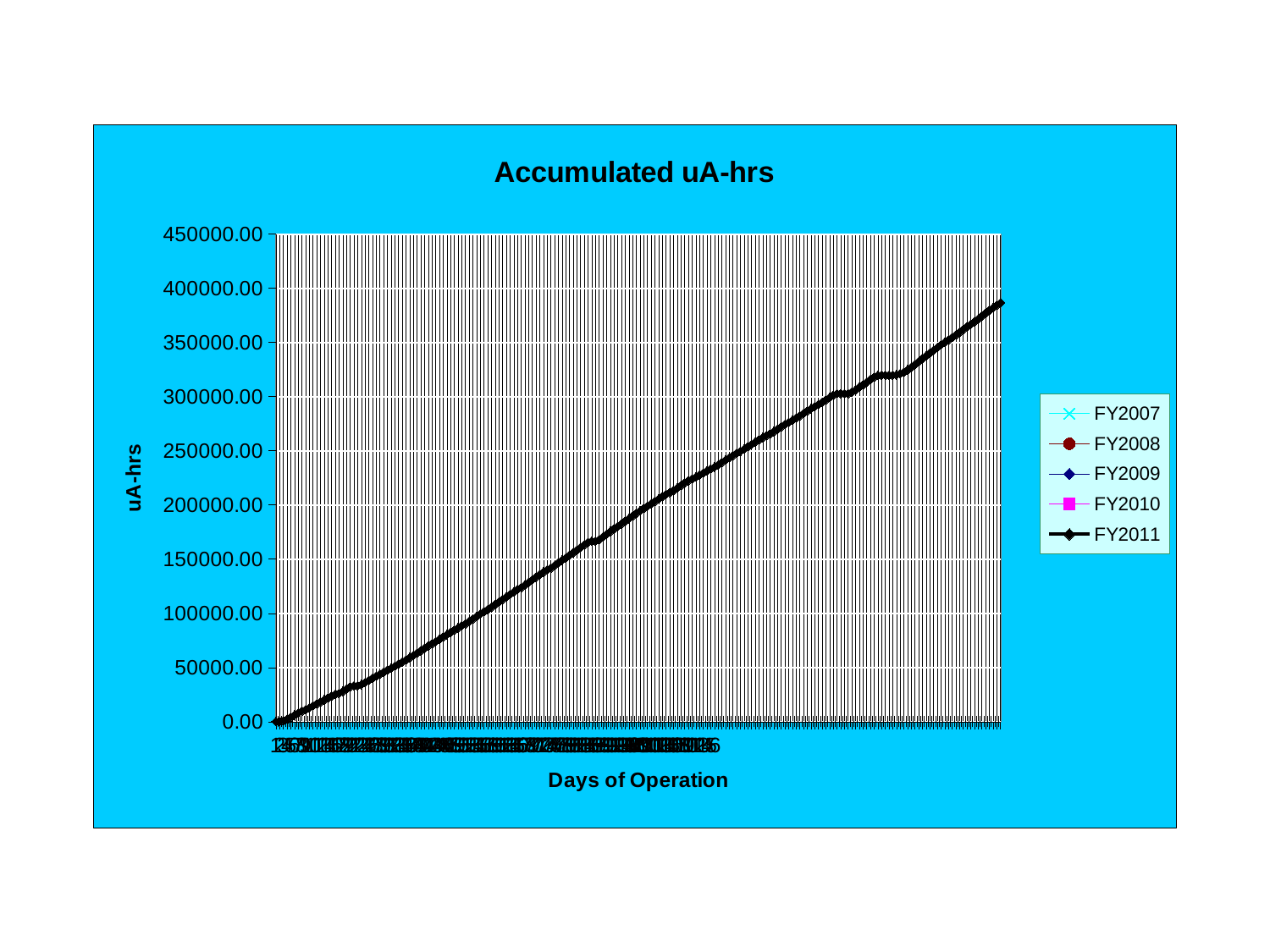
Is the final value reached by the FY2011 line greater or less than 350000.00? greater How many series does the legend list? 5 Is the value of the FY2011 line at the midpoint of the x axis greater or less than 250000.00? less Does the FY2011 line rise or fall as the days of operation increase? rise What is the title of the chart? Accumulated uA-hrs Is the final value reached by the FY2011 line greater or less than 400000.00? less Which series is drawn as the thick black line rising across the chart? FY2011 What kind of chart is shown on the slide? line chart